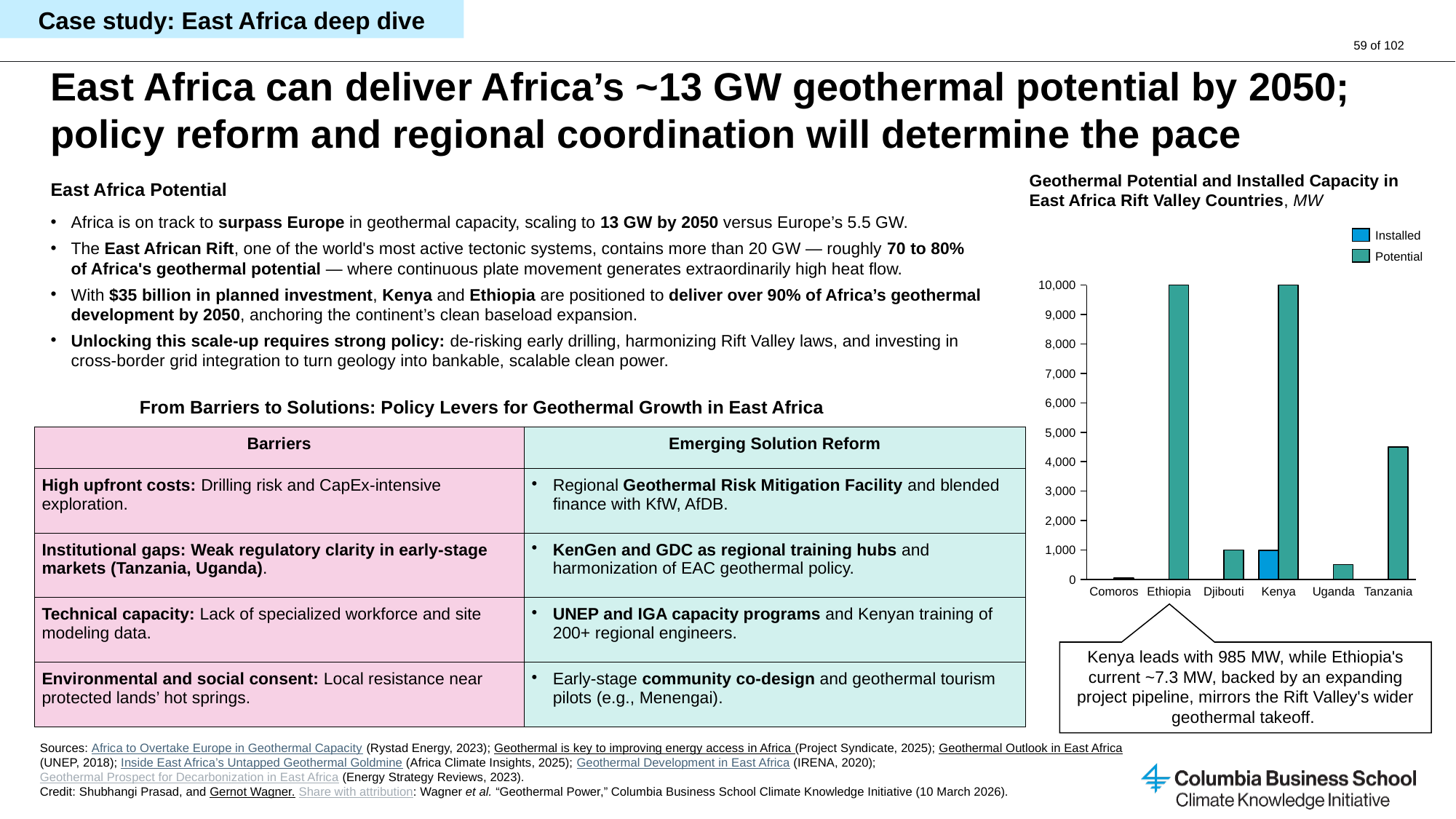
What is the geothermal potential shown for Ethiopia in the chart? 10,000 Is the geothermal potential for Uganda greater or less than 1,000? less In what unit are the values in the geothermal capacity chart expressed? MW Which country has the highest installed geothermal capacity in the chart? Kenya How many countries are shown on the x axis of the geothermal capacity chart? 6 Is the geothermal potential for Tanzania greater or less than 4,000? greater What kind of chart is used to show geothermal potential and installed capacity in East Africa Rift Valley countries? Bar chart How many series does the legend of the geothermal capacity chart list? 2 What is the geothermal potential shown for Djibouti in the chart? 1,000 What is Kenya's installed geothermal capacity according to the slide? 985 MW Which country has the lowest geothermal potential in the chart? Comoros Which has the larger geothermal potential, Tanzania or Djibouti? Tanzania